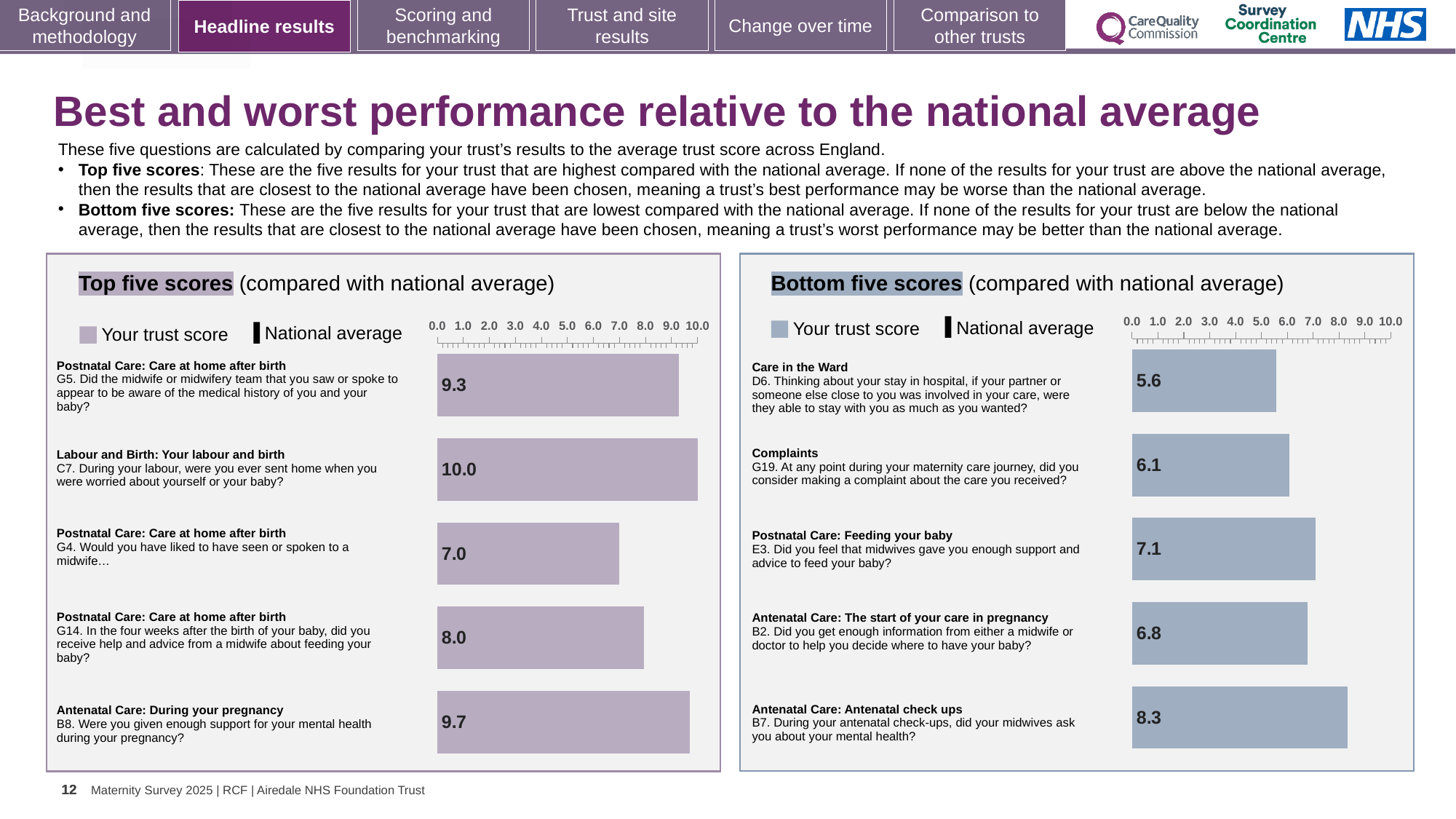
In the Bottom five scores chart, which has the larger trust score: G19 (Complaints) or B2 (The start of your care in pregnancy)? B2 How many questions are plotted in the Top five scores chart? 5 In the Bottom five scores chart, what is the difference between the trust scores for B7 and D6? 2.7 In the Top five scores chart, which question has the highest trust score? C7 (Labour and Birth: Your labour and birth) In the Top five scores chart, which question has the lowest trust score? G4 (Would you have liked to have seen or spoken to a midwife…) What kind of chart is the Bottom five scores chart? Bar chart In the Top five scores chart, what is the difference between the trust scores for C7 and G4? 3.0 In the Bottom five scores chart, which question has the lowest trust score? D6 (Care in the Ward) In the Bottom five scores chart, what is the trust score for D6 (Care in the Ward)? 5.6 In the Top five scores chart, what is the trust score for B8 (Were you given enough support for your mental health during your pregnancy?)? 9.7 In the Top five scores chart, what is the trust score for C7 (During your labour, were you ever sent home when you were worried about yourself or your baby?)? 10.0 In the Bottom five scores chart, which question has the highest trust score? B7 (Antenatal check ups)